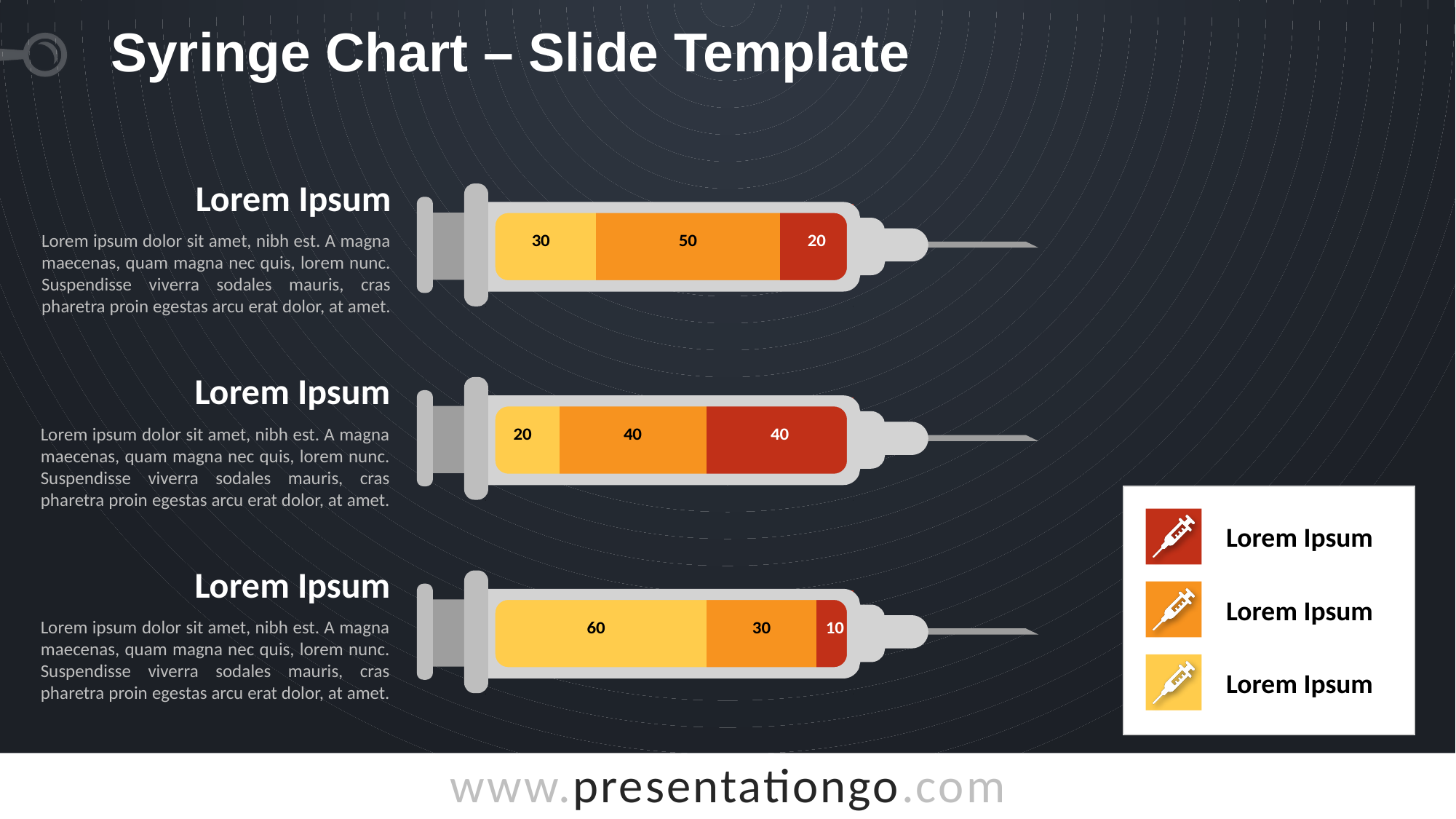
What is the total of the three segments in the middle syringe chart? 100 In the top syringe chart, what is the difference between the orange segment and the red segment? 30 How many segments does each syringe chart contain? 3 In the bottom syringe chart, what is the value of the red segment? 10 How many entries does the legend on the right list? 3 In the bottom syringe chart, is the yellow segment larger or smaller than the orange segment? Larger In the top syringe chart, which segment has the largest value? Orange (50) In the bottom syringe chart, what is the value of the yellow segment? 60 In the bottom syringe chart, which segment has the smallest value? Red (10) In the top syringe chart, what is the value of the orange segment? 50 In the top syringe chart, what is the value of the yellow segment? 30 In the middle syringe chart, what is the value of the red segment? 40